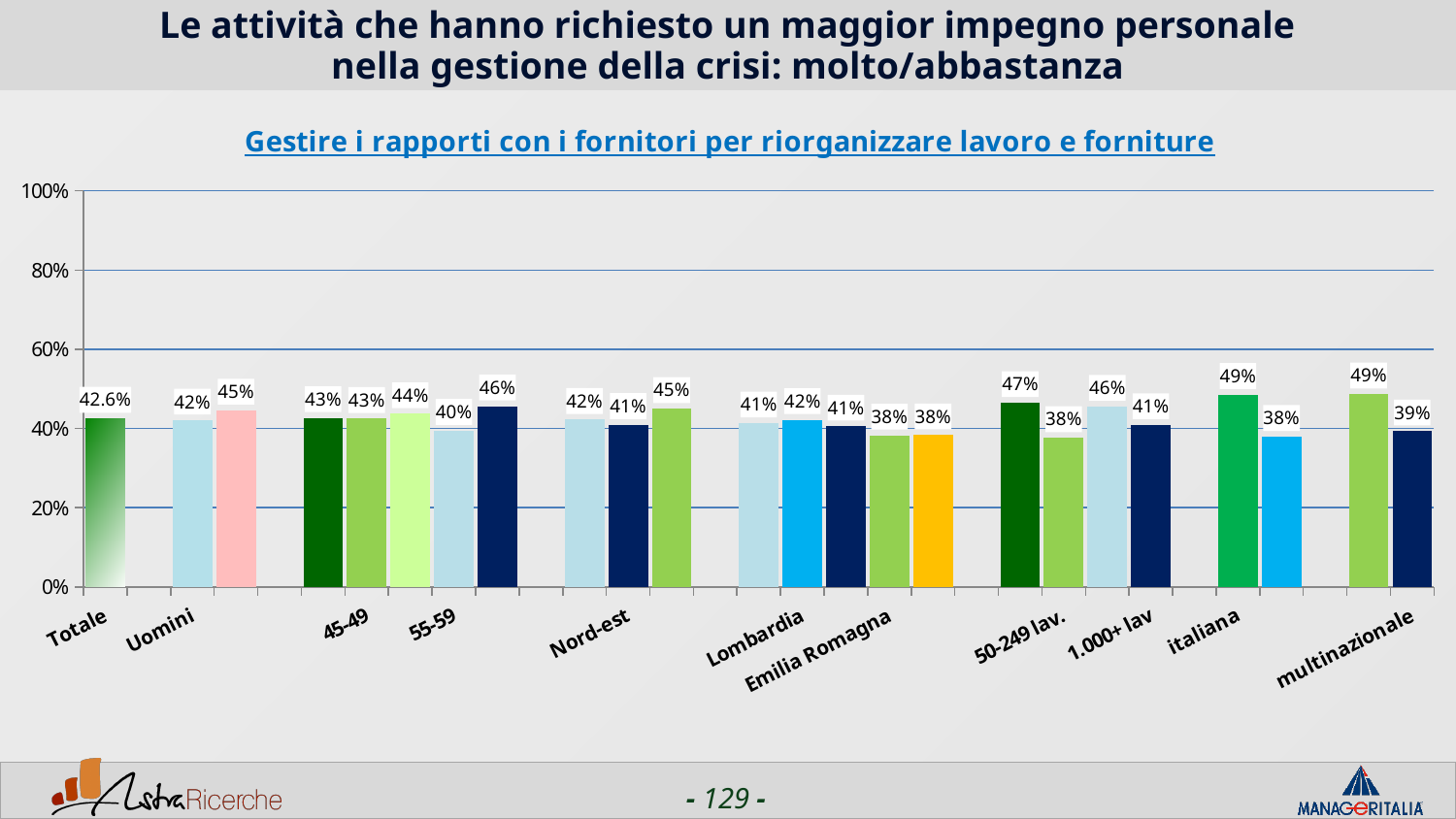
What is the value for Uomini? 42% Which is larger, the value for italiana or the value for multinazionale? italiana What is the value for Totale? 42.6% What is the value for Nord-est? 41% What is the difference between the value for Totale and the value for Uomini? 0.6 percentage points What is the subtitle of the chart, shown in blue above the plot? Gestire i rapporti con i fornitori per riorganizzare lavoro e forniture What type of chart is shown on the slide? bar chart Is the value for Totale greater or less than 40%? greater What is the value for multinazionale? 39% What is the value for italiana? 49% Is the value for italiana greater or less than 60%? less What is the difference between the value for italiana and the value for multinazionale? 10 percentage points